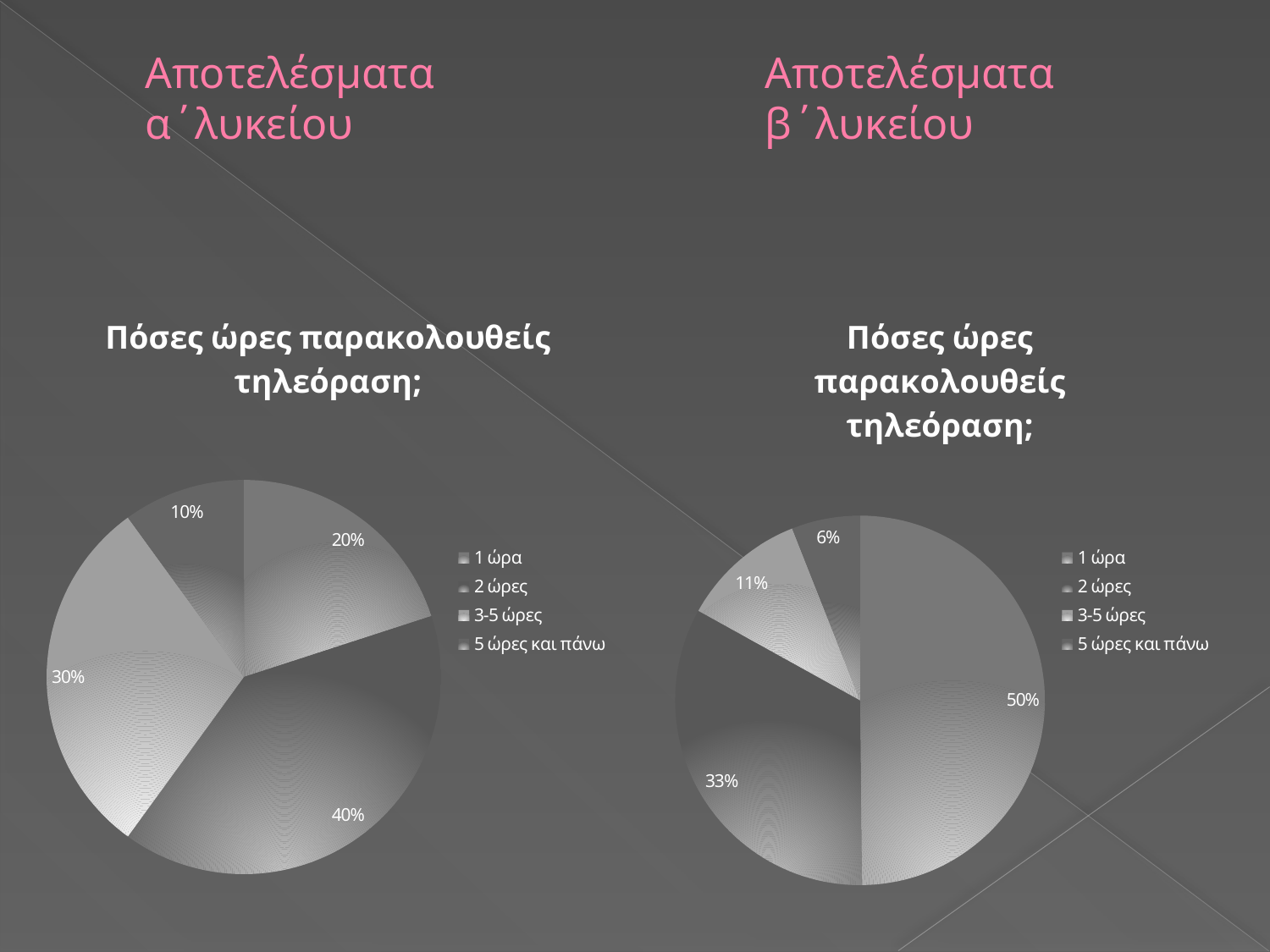
Which is larger: the largest slice of the left pie chart (α΄λυκείου) or the largest slice of the right pie chart (β΄λυκείου)? the right pie chart (50%) In the left pie chart (α΄λυκείου), what is the largest percentage shown? 40% In the left pie chart (α΄λυκείου), what is the difference between the largest slice (40%) and the smallest slice (10%)? 30 percentage points How many entries does the legend of the right pie chart (β΄λυκείου) list? 4 What kind of chart is shown under "Αποτελέσματα α΄λυκείου"? pie chart What is the last entry in the legend of the left pie chart (α΄λυκείου)? 5 ώρες και πάνω In the left pie chart (α΄λυκείου), what is the smallest percentage shown? 10% In the right pie chart (β΄λυκείου), what is the difference between the 33% slice and the 11% slice? 22 percentage points How many slices does the left pie chart (α΄λυκείου) have? 4 In the right pie chart (β΄λυκείου), what is the smallest percentage shown? 6% In the right pie chart (β΄λυκείου), what is the largest percentage shown? 50% What is the title of the pie chart under "Αποτελέσματα β΄λυκείου"? Πόσες ώρες παρακολουθείς τηλεόραση;